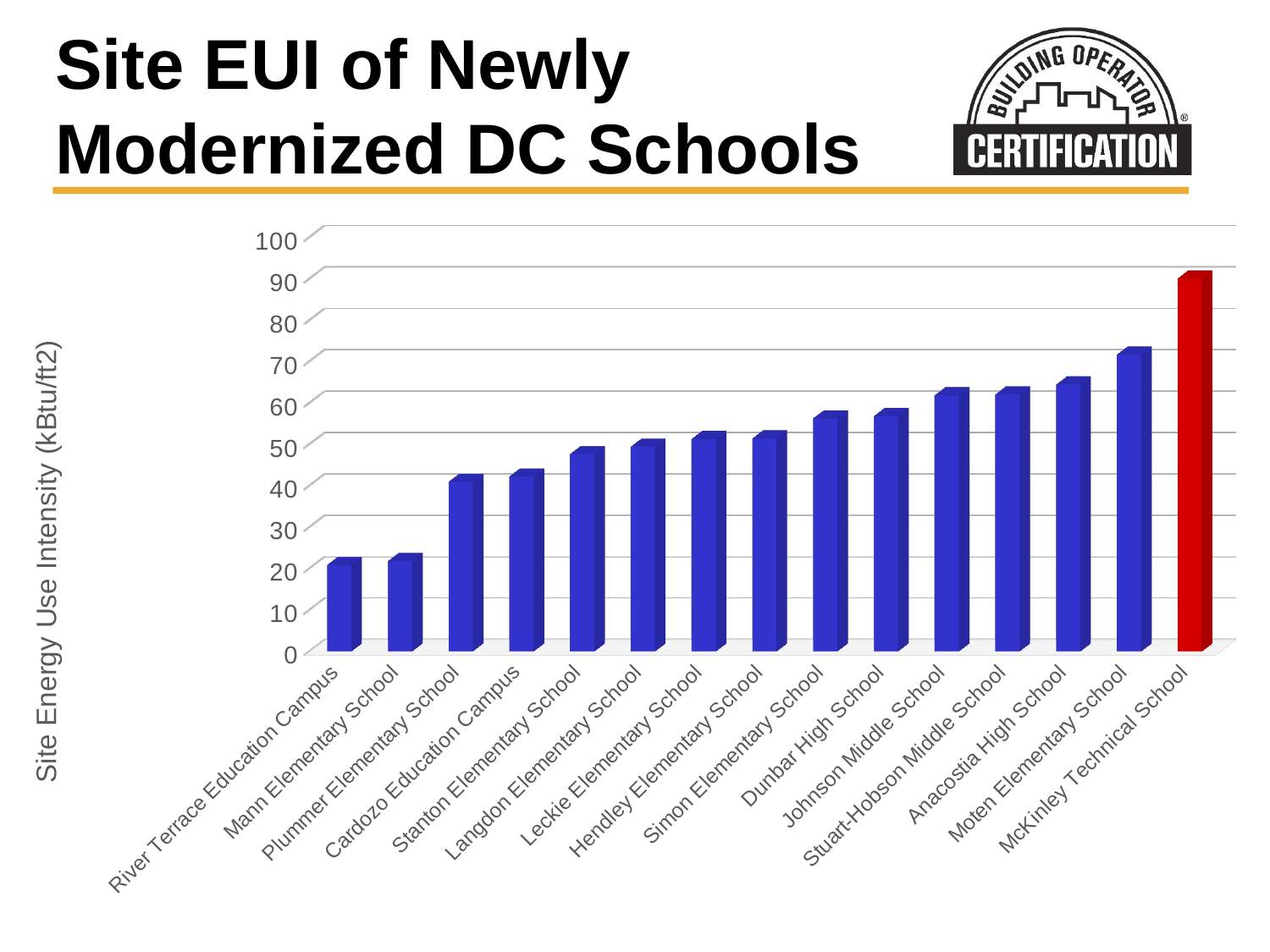
Is the value for McKinley Technical School greater or less than 80? greater Is the value for Moten Elementary School greater or less than 60? greater Which has a higher Site EUI, McKinley Technical School or Moten Elementary School? McKinley Technical School How many schools are plotted on the chart? 15 Is the value for Plummer Elementary School greater or less than 50? less What kind of chart is shown on the slide? bar chart Which school has the highest Site EUI on the chart? McKinley Technical School Which has a higher Site EUI, Plummer Elementary School or Mann Elementary School? Plummer Elementary School Do the values rise or fall moving from left to right across the chart? rise What is the label on the vertical axis of the chart? Site Energy Use Intensity (kBtu/ft2)